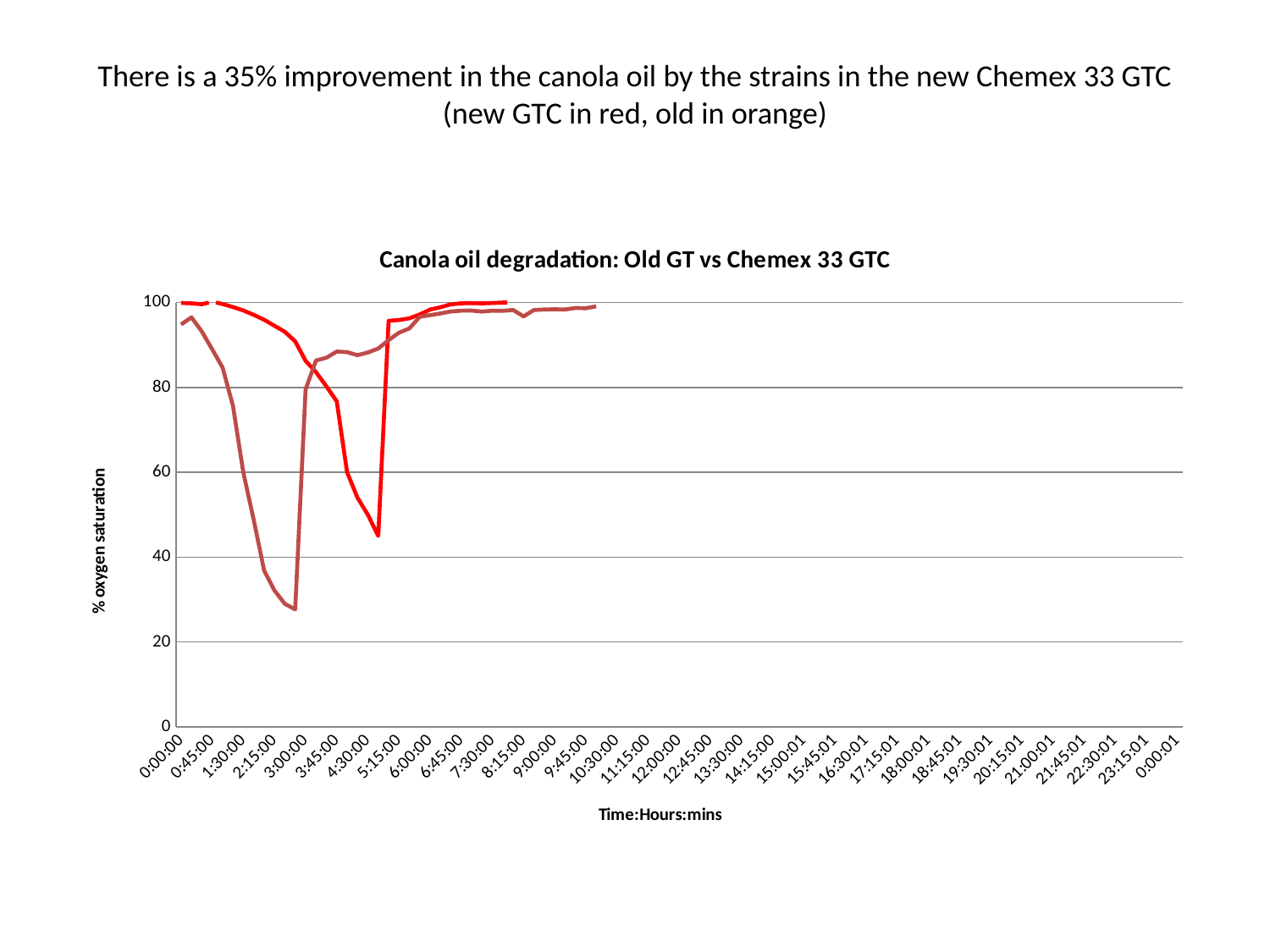
Between 0:00:00 and 3:00:00, does the orange line rise or fall overall? fall Is the lowest value reached by the orange line greater or less than 40? less Is the value of the red line at 0:00:00 greater or less than 80? greater Is the value of the orange line at 0:00:00 greater or less than 80? greater What kind of chart is shown on the slide? line chart Which line reaches its minimum earlier in time, the red line or the orange line? orange What is the title of the chart? Canola oil degradation: Old GT vs Chemex 33 GTC After reaching its minimum, does the orange line rise or fall as time increases? rise Which colour line represents the new Chemex 33 GTC? red Which line drops to a lower minimum % oxygen saturation, the red line or the orange line? orange